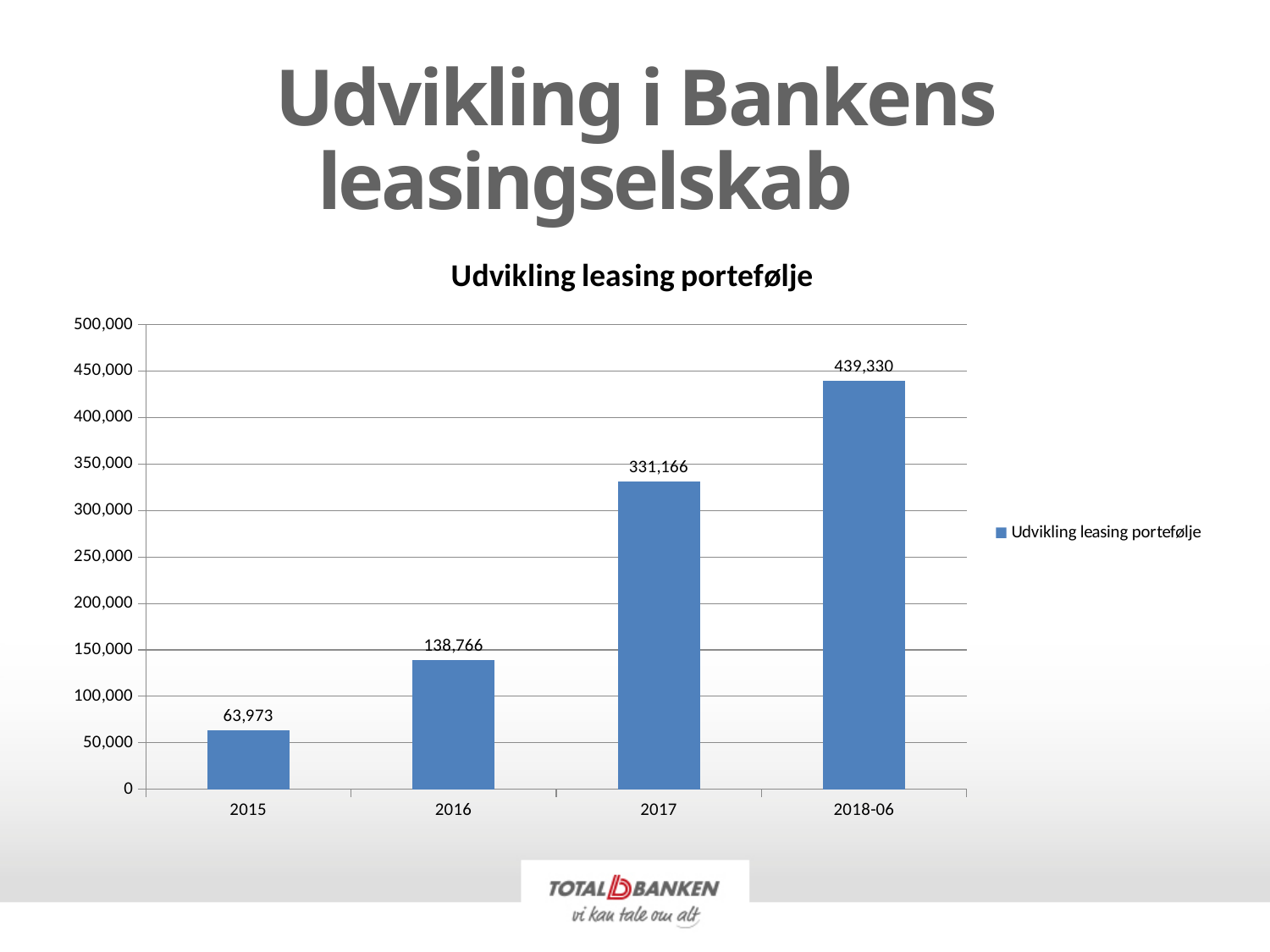
What is the difference between the values for 2016 and 2015? 74,793 Which category has the lowest value? 2015 Do the values rise or fall from 2015 to 2018-06? Rise What is the value for 2015? 63,973 What is the value for 2018-06? 439,330 What is the value for 2016? 138,766 Which is larger, the value for 2016 or the value for 2017? 2017 What kind of chart is shown? Bar chart How many categories are shown on the x axis? 4 Which category has the highest value? 2018-06 What is the difference between the values for 2018-06 and 2017? 108,164 What is the value for 2017? 331,166